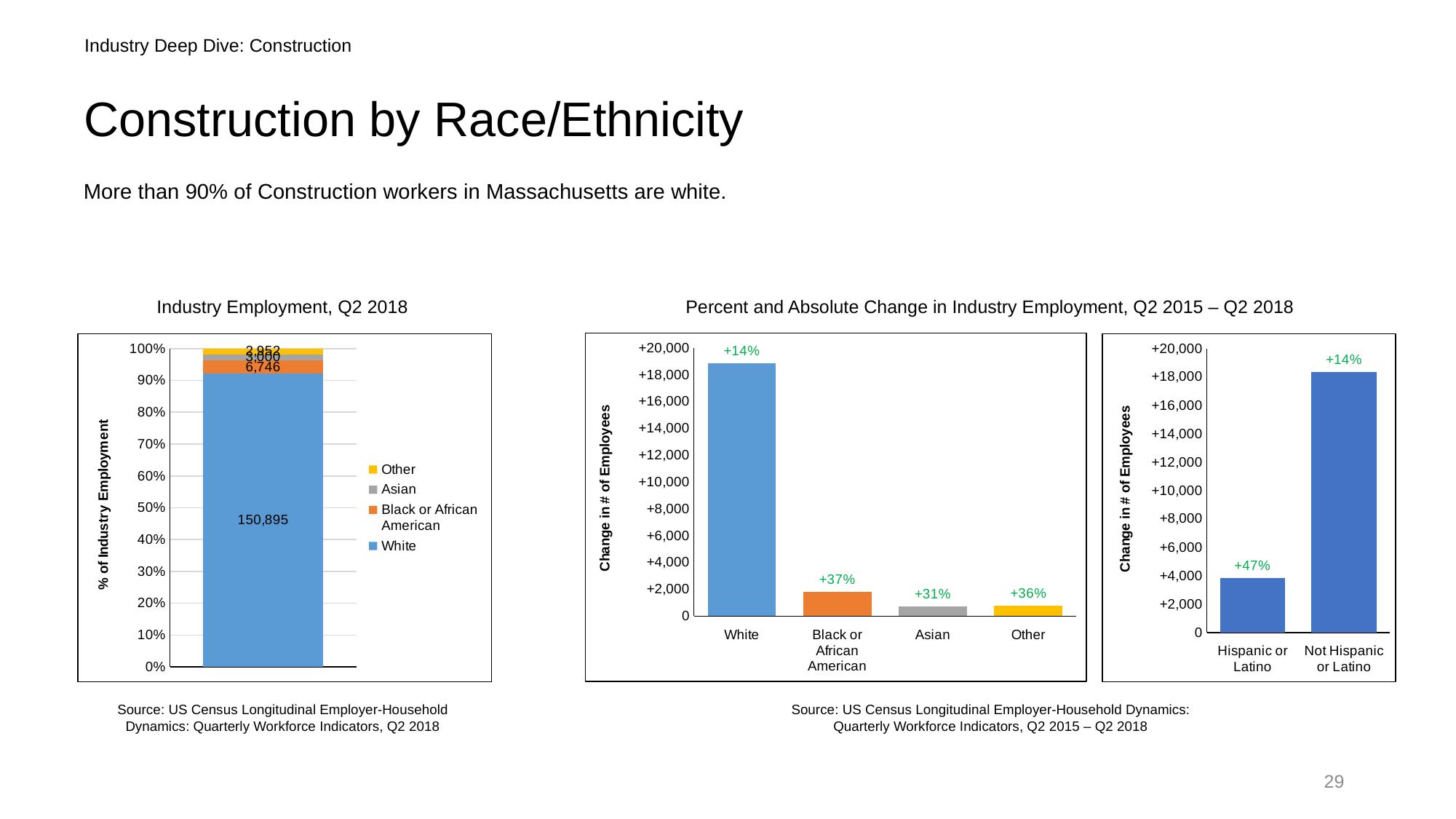
In the rightmost chart (change in employment by Hispanic or Latino status), which bar is taller: Hispanic or Latino, or Not Hispanic or Latino? Not Hispanic or Latino In the middle chart (Percent and Absolute Change in Industry Employment by race), is the bar for White greater or less than 18,000? greater In the Industry Employment, Q2 2018 chart, what is the value shown for White? 150,895 In the Industry Employment, Q2 2018 chart, what is the difference between the White value and the Black or African American value? 144,149 How many categories are shown on the x axis of the middle chart (Percent and Absolute Change in Industry Employment by race)? 4 In the middle chart (Percent and Absolute Change in Industry Employment by race), which category has the tallest bar? White In the middle chart (Percent and Absolute Change in Industry Employment by race), what percent change is shown for Black or African American? +37% In the middle chart (Percent and Absolute Change in Industry Employment by race), what percent change is shown for Asian? +31% How many series does the legend of the Industry Employment, Q2 2018 chart list? 4 In the rightmost chart (change in employment by Hispanic or Latino status), what percent change is shown for Hispanic or Latino? +47% In the middle chart (Percent and Absolute Change in Industry Employment by race), which category has the shortest bar? Asian In the Industry Employment, Q2 2018 chart, what is the value shown for Black or African American? 6,746